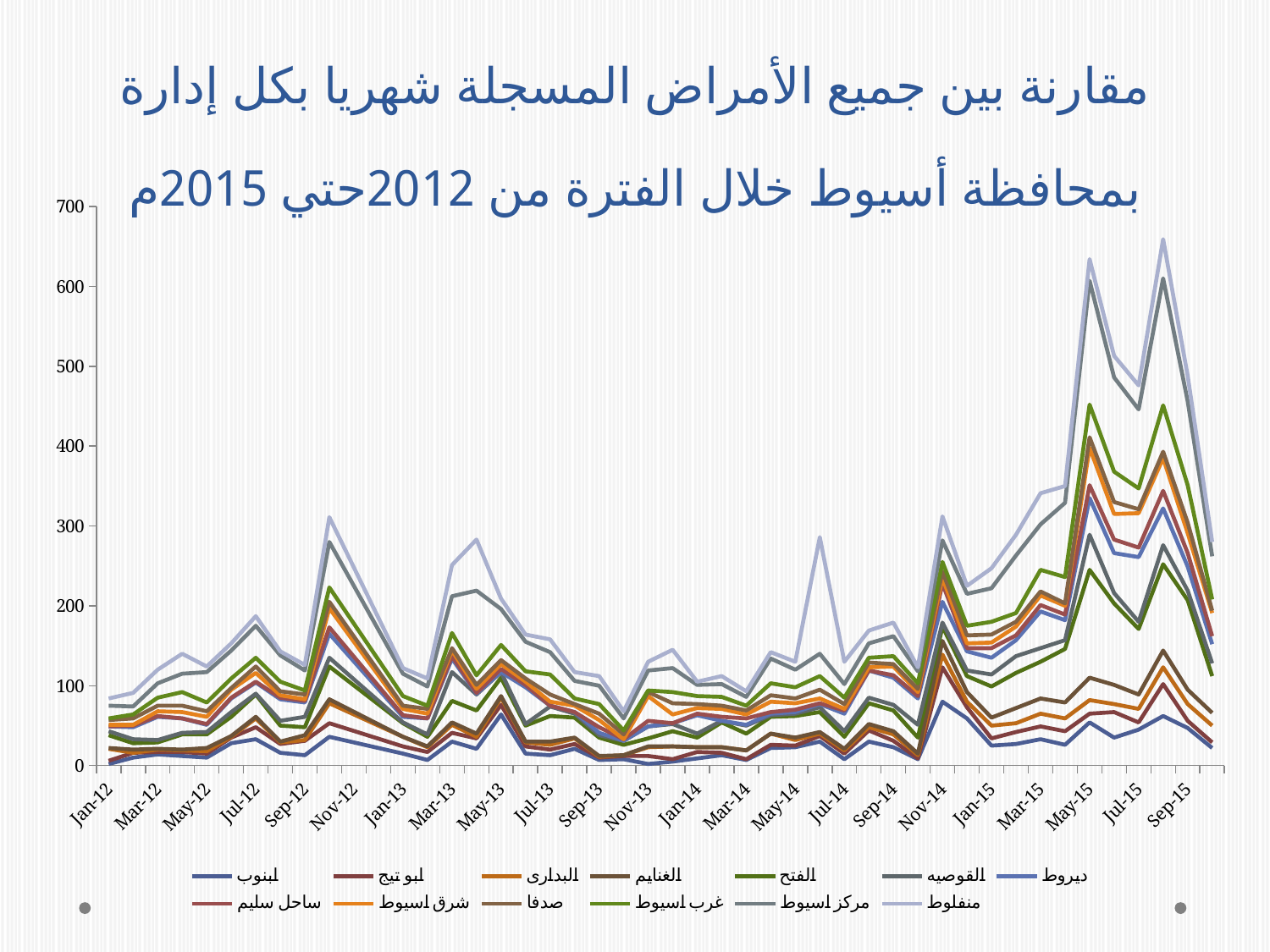
Is the peak of منفلوط in 2015 higher or lower than its peak in 2012? higher Is the highest point plotted on the chart greater or less than 600? greater How many series does the legend list? 13 Which series stays lowest across most of the chart? ابنوب Do the peak values of the series generally rise or fall from 2012 to 2015? rise What kind of chart is shown on the slide? line chart Which series reaches the highest peak on the chart? منفلوط Is the highest point plotted on the chart greater or less than 700? less What is the first month label on the horizontal axis? Jan-12 Are the values for منفلوط in Jan-12 greater or less than 100? less What is the highest value shown on the vertical axis? 700